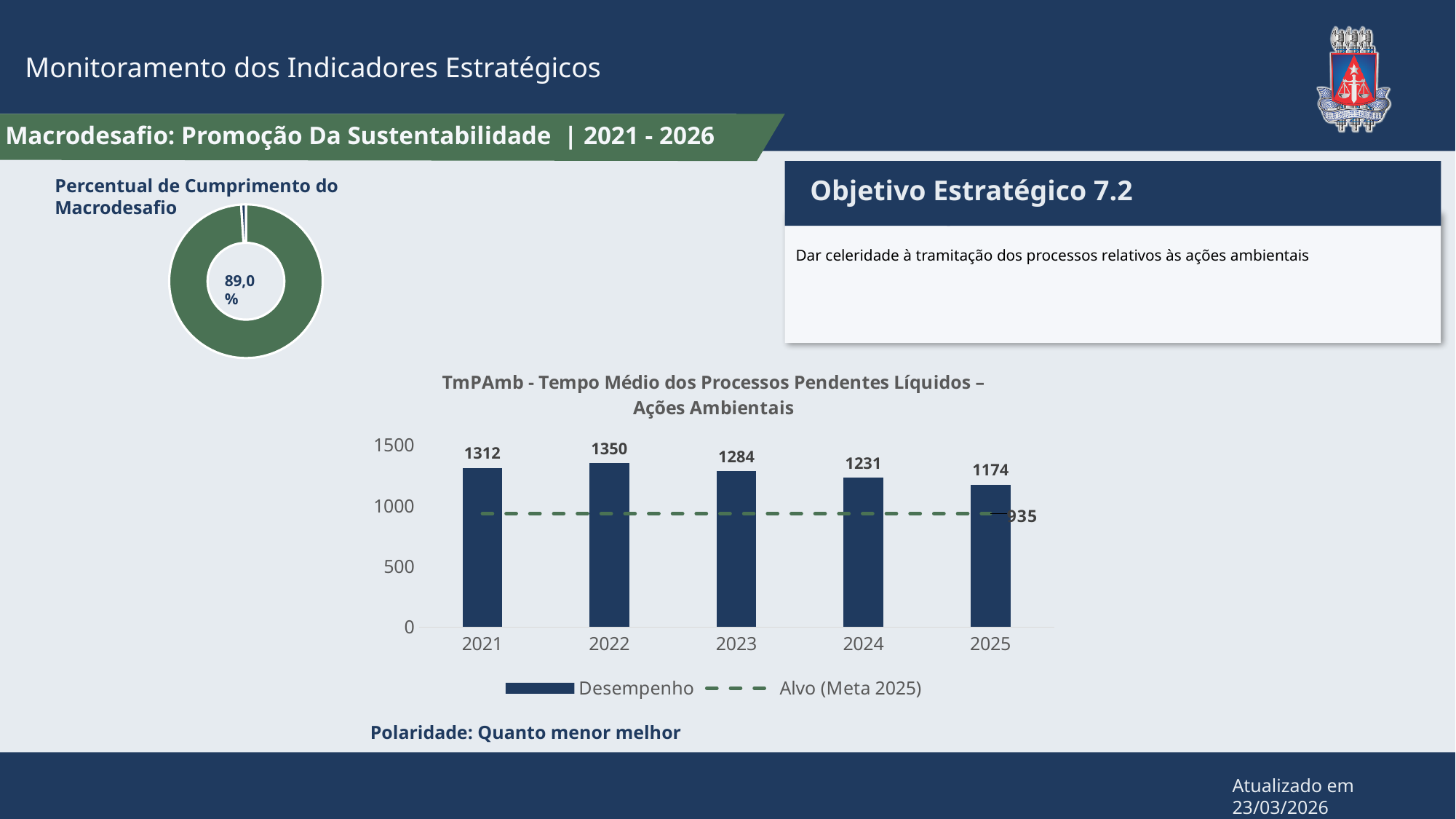
In the TmPAmb bar chart, how many series does the legend list? 2 What percentage is shown in the centre of the 'Percentual de Cumprimento do Macrodesafio' donut chart? 89,0% In the TmPAmb bar chart, what is the value of the Alvo (Meta 2025) line? 935 In the TmPAmb bar chart, which year has the highest Desempenho value? 2022 In the TmPAmb bar chart, how many years are shown on the x axis? 5 In the TmPAmb bar chart, is the Desempenho value for 2023 larger than the value for 2024? Yes In the TmPAmb bar chart, do the Desempenho values rise or fall from 2022 to 2025? Fall What type of chart is the 'Percentual de Cumprimento do Macrodesafio' chart? Donut chart In the TmPAmb bar chart, what is the Desempenho value for 2025? 1174 In the TmPAmb bar chart, what is the difference between the 2021 and 2025 Desempenho values? 138 In the TmPAmb bar chart, which year has the lowest Desempenho value? 2025 In the TmPAmb bar chart, what is the Desempenho value for 2022? 1350